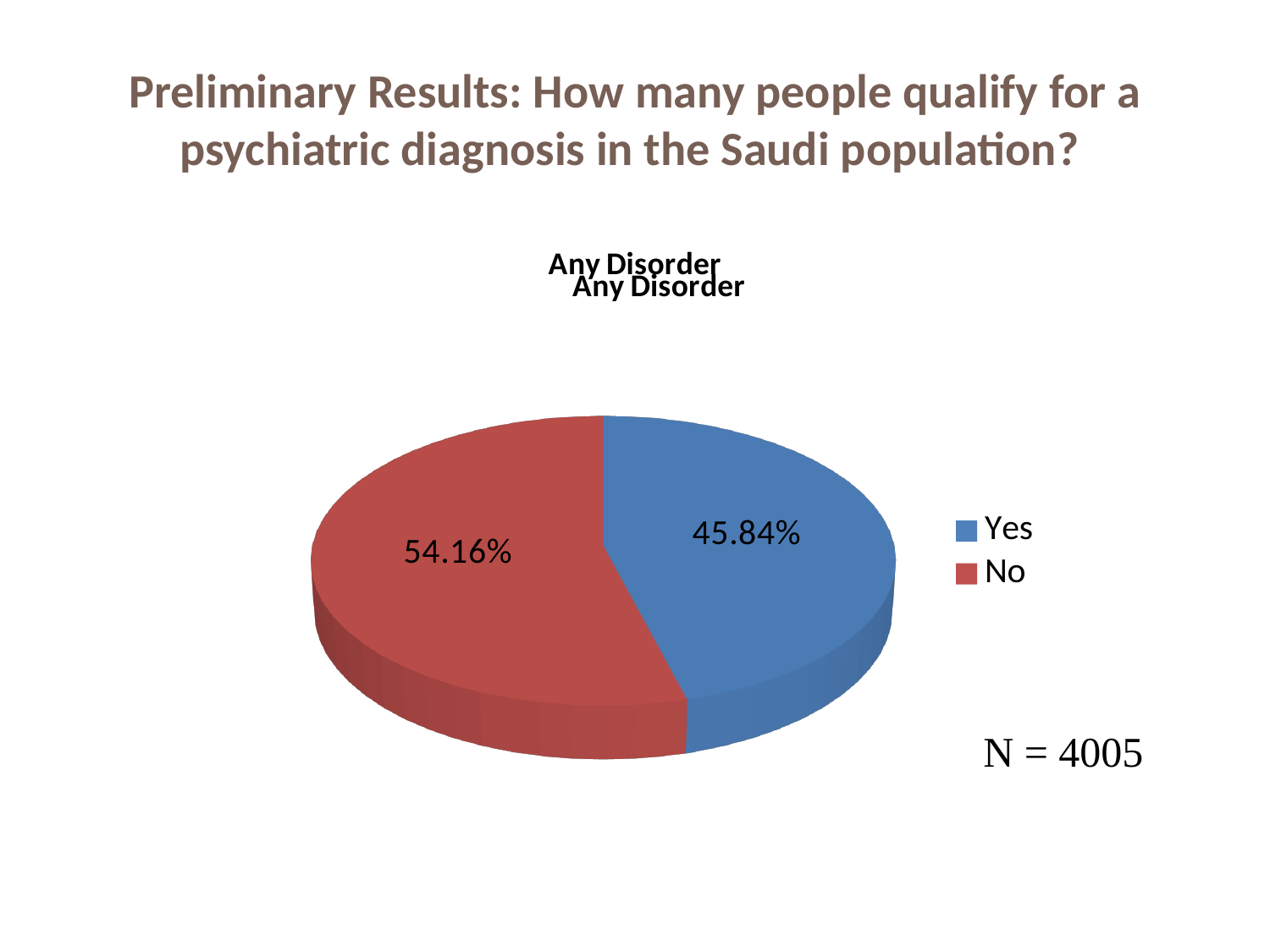
Which slice of the pie is the largest? No What is the title of the chart? Any Disorder What is the difference in percentage points between the "No" slice and the "Yes" slice? 8.32 How many entries does the legend list? 2 What colour is the "Yes" slice? Blue What percentage of the pie is labelled "No"? 54.16% What percentage of the pie is labelled "Yes"? 45.84% Which is larger, the "Yes" slice or the "No" slice? No Which slice of the pie is the smallest? Yes What is the sample size (N) shown next to the chart? N = 4005 What kind of chart is shown on the slide? Pie chart How many slices does the pie chart have? 2